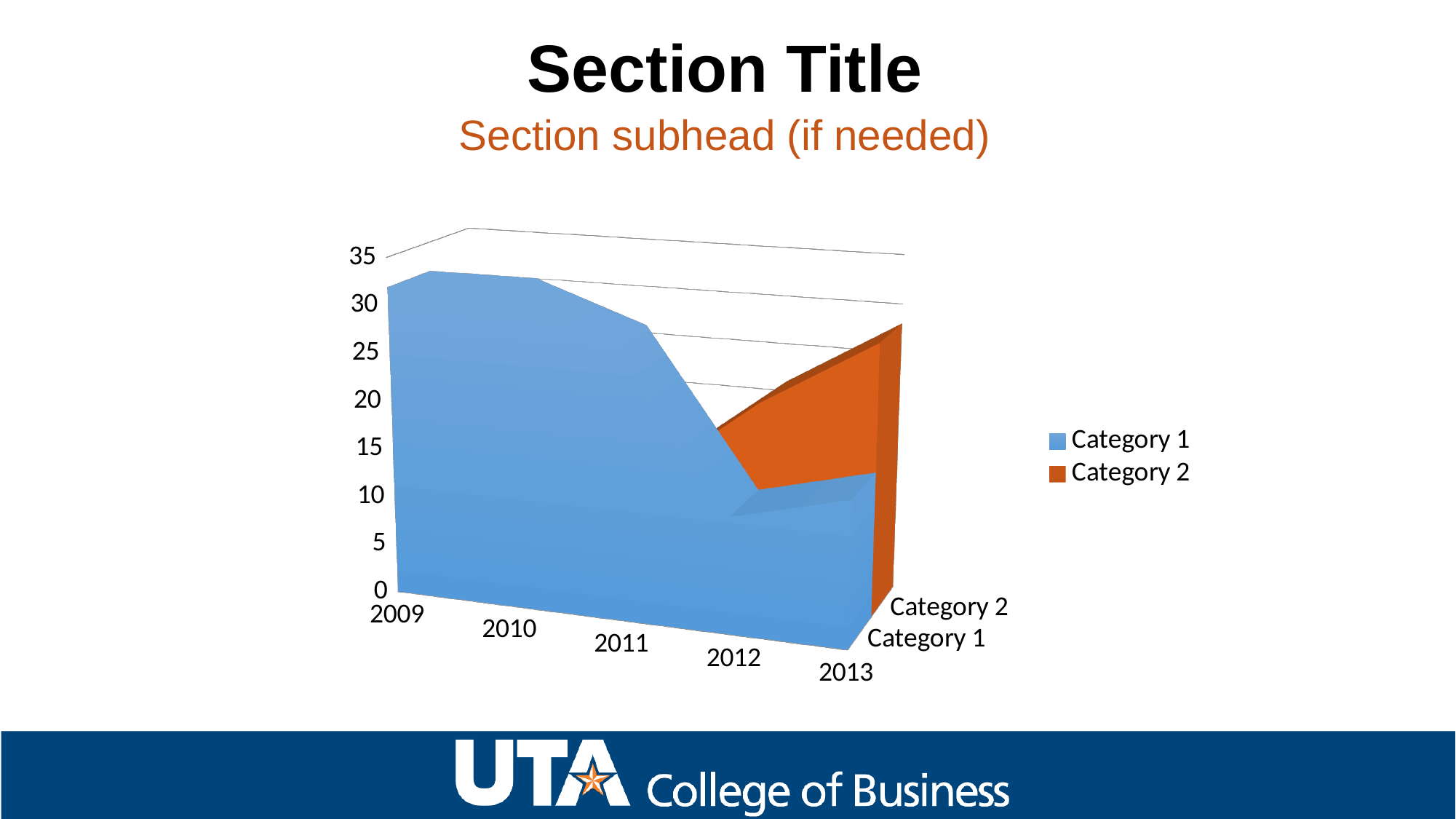
How many years are shown along the x axis? 5 How many series does the legend list? 2 Does the value for Category 1 rise or fall from 2009 to 2013? fall Which is larger for Category 1: the value in 2009 or the value in 2012? 2009 In 2013, which series has the larger value, Category 1 or Category 2? Category 2 Is the value for Category 2 in 2013 greater or less than 15? greater What colour is used for Category 1? blue What kind of chart is shown on the slide? area chart Which series are listed in the legend? Category 1 and Category 2 Is the value for Category 1 in 2013 greater or less than 20? less Is the value for Category 1 in 2009 greater or less than 25? greater